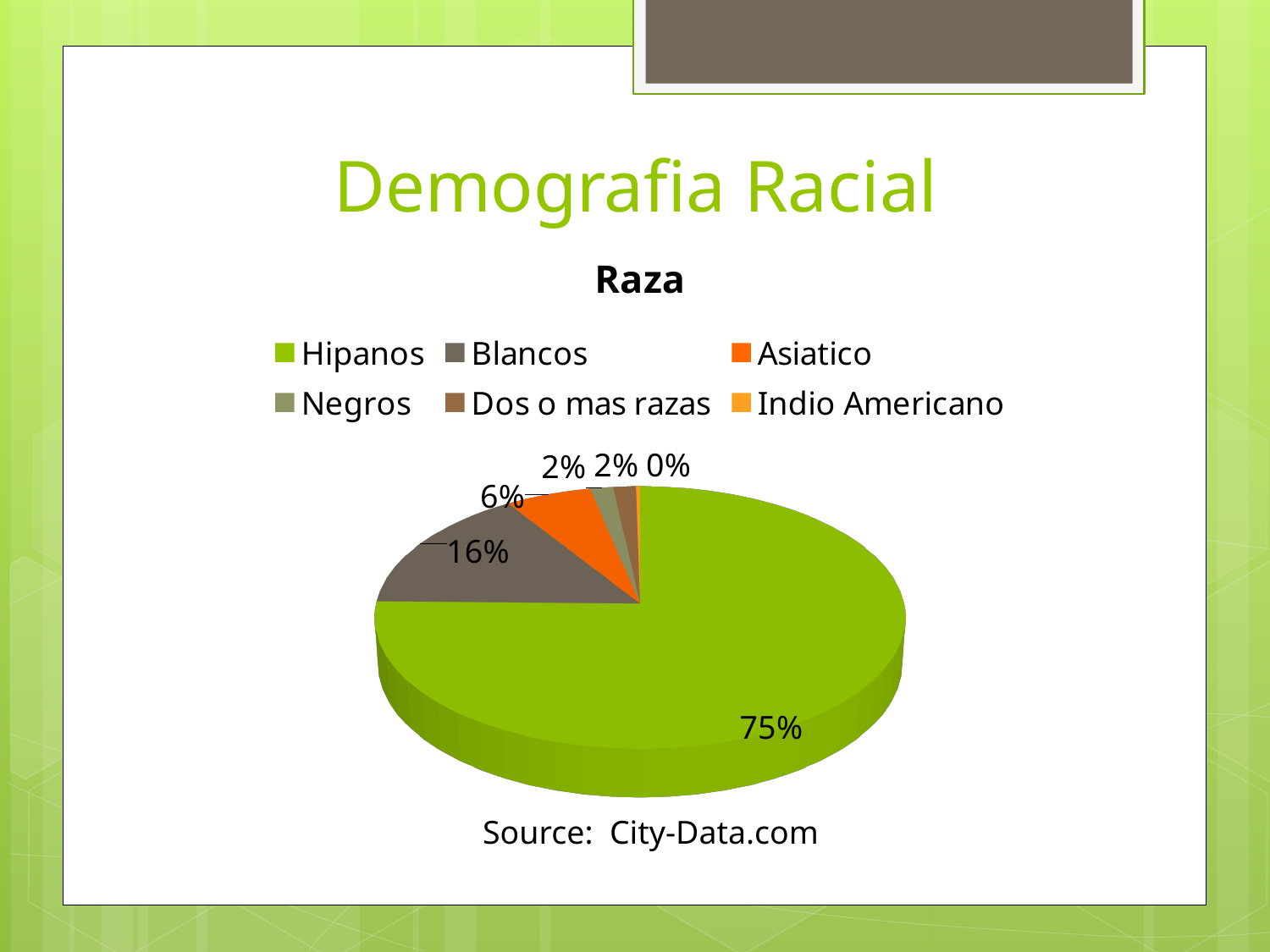
What percentage is shown for Negros? 2% What percentage of the pie does Hipanos represent? 75% What is the difference in percentage points between Hipanos and Blancos? 59% Which category has the largest share of the pie? Hipanos What is the title of the chart? Raza How many categories does the pie chart show? 6 What is the value shown for Blancos? 16% What type of chart is shown on the slide? Pie chart What percentage is shown for Asiatico? 6% What percentage is shown for Indio Americano? 0% Which category has the smallest share of the pie? Indio Americano Which is larger, the share for Blancos or the share for Asiatico? Blancos